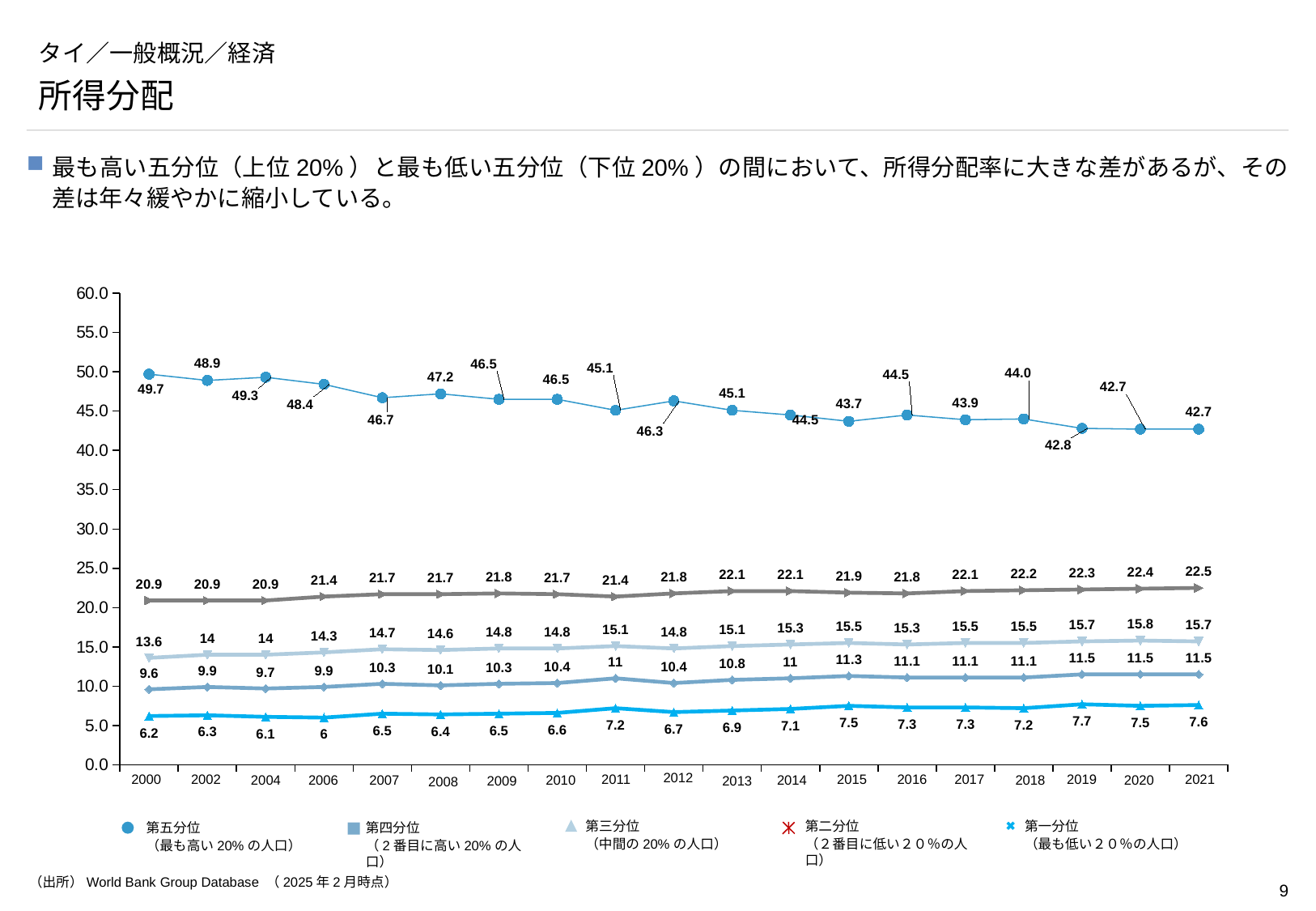
2021年における第五分位と第一分位の値の差はいくつですか？ 35.1 第五分位（最も高い20%の人口）の2000年の値はいくつですか？ 49.7 第五分位の値が最も高いのは何年ですか？ 2000 2000年における第五分位と第一分位の値の差はいくつですか？ 43.5 第四分位の2013年の値はいくつですか？ 22.1 第一分位の値が最も低いのは何年ですか？ 2006 2011年の第三分位と第二分位では、どちらの値が大きいですか？ 第三分位 第五分位の値は2000年から2021年にかけて上昇していますか、下降していますか？ 下降 凡例にはいくつの系列が示されていますか？ 5 第一分位（最も低い20%の人口）の2021年の値はいくつですか？ 7.6 このグラフの種類は何ですか？ 折れ線グラフ 横軸には何年分のデータ点がありますか？ 19